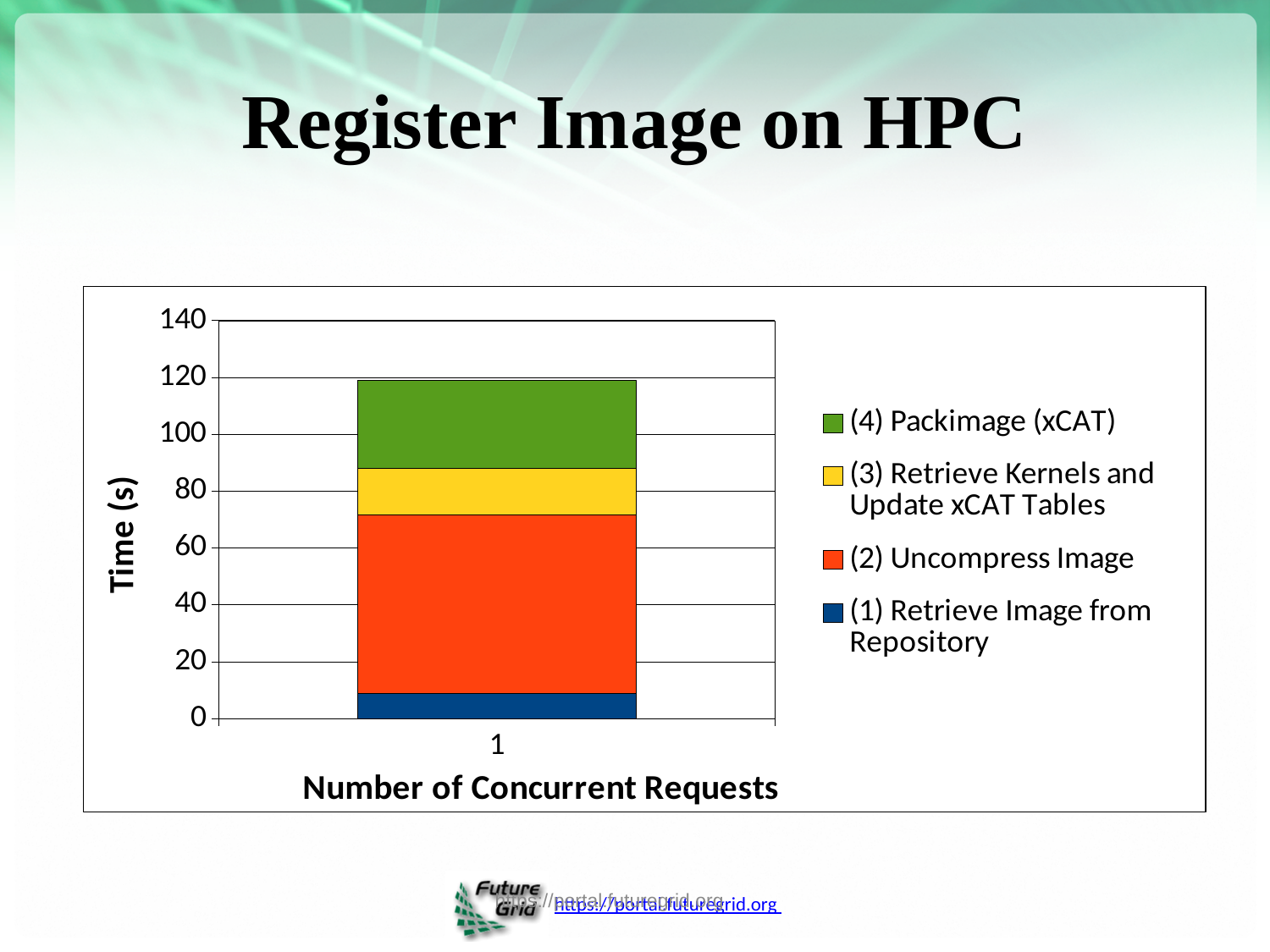
How many series does the legend list? 4 Is the total height of the stacked bar greater or less than 140? less How many categories are plotted on the x axis? 1 Is the segment for (1) Retrieve Image from Repository greater or less than 20? less Which segment is larger, (4) Packimage (xCAT) or (3) Retrieve Kernels and Update xCAT Tables? (4) Packimage (xCAT) Which series contributes the largest segment to the stacked bar? (2) Uncompress Image What is the title of the y axis? Time (s) What is the title of the x axis? Number of Concurrent Requests Which series contributes the smallest segment to the stacked bar? (1) Retrieve Image from Repository Is the segment for (2) Uncompress Image greater or less than 40? greater What kind of chart is shown on the slide? stacked bar chart